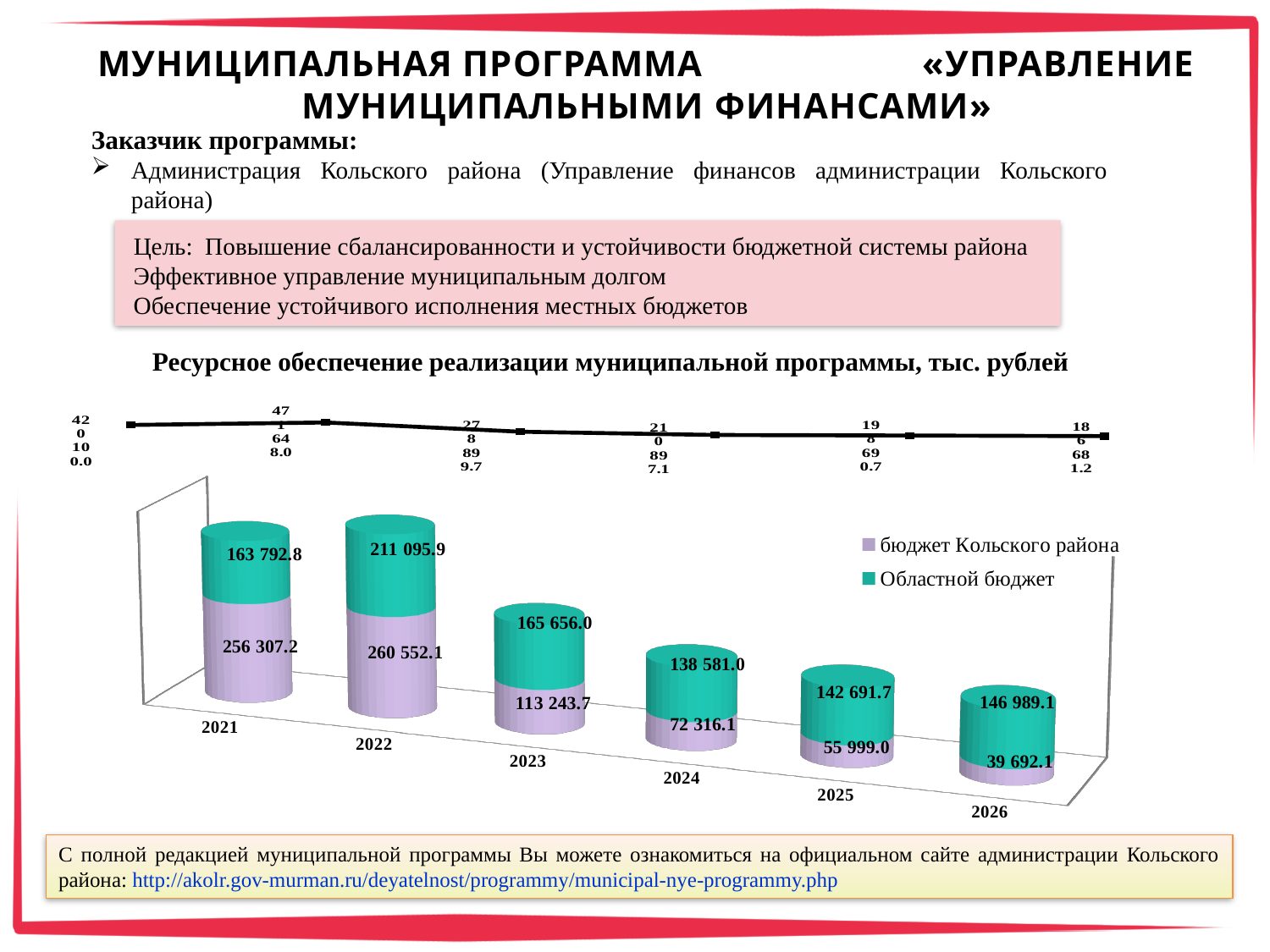
What is the total of the stacked bar for 2021? 420 100.0 How many series does the chart legend list? 2 What is the value of «бюджет Кольского района» for 2024? 72 316.1 In which year is «бюджет Кольского района» the highest? 2022 What is the difference between «бюджет Кольского района» and «Областной бюджет» in 2021? 92 514.4 What is the total of the stacked bar for 2026? 186 681.2 Does «бюджет Кольского района» rise or fall from 2022 to 2026? fall What is the value of «Областной бюджет» for 2022? 211 095.9 In 2023, which is larger: «Областной бюджет» or «бюджет Кольского района»? Областной бюджет In which year is «Областной бюджет» the lowest? 2024 In which year is «бюджет Кольского района» the lowest? 2026 How many years are shown on the x axis of the chart? 6